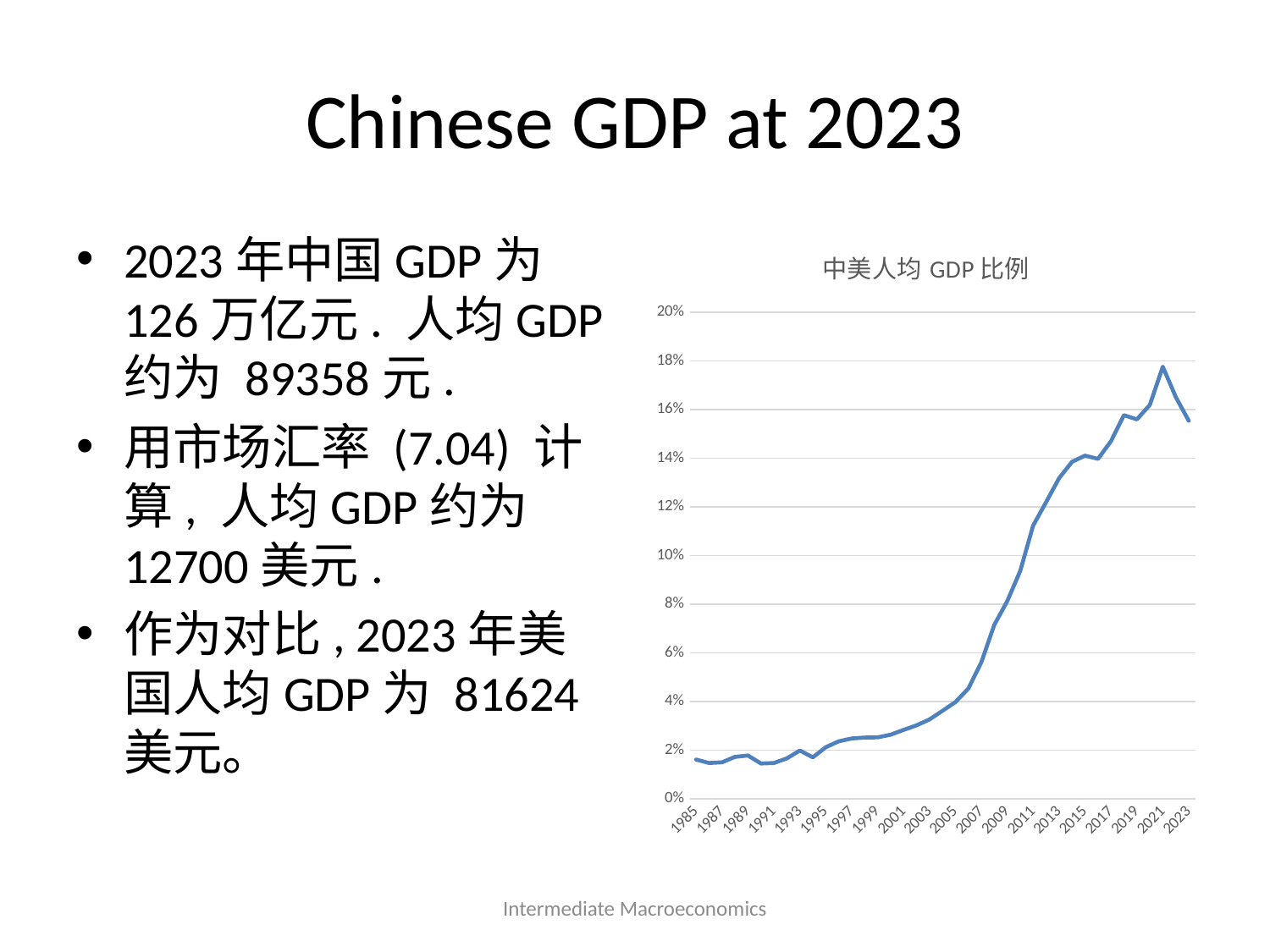
What kind of chart is shown on the slide? line chart In which year does the line reach its highest point? 2021 Overall, does the line rise or fall from 1985 to 2023? rise Is the value for 2021 greater or less than 16%? greater What is the title of the chart on the slide? 中美人均 GDP 比例 Which year has the larger value, 1985 or 2005? 2005 Is the value for 2023 greater or less than 14%? greater Is the value for 1985 greater or less than 2%? less Does the line rise or fall between 2021 and 2023? fall What is the highest value shown on the chart's vertical axis? 20% Which year has the larger value, 2021 or 2023? 2021